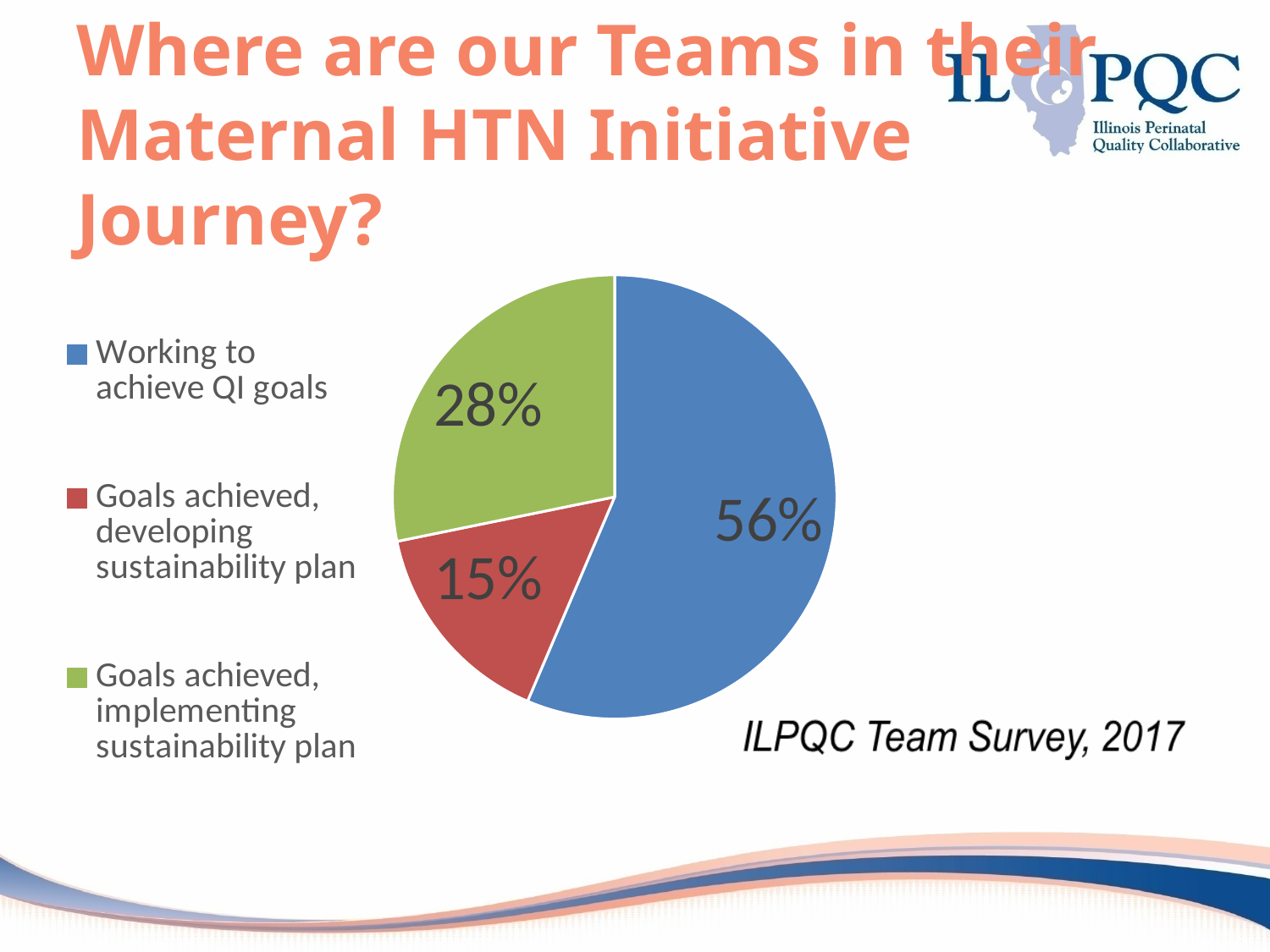
Which category has the smallest slice of the pie? Goals achieved, developing sustainability plan What is the difference in percentage points between 'Working to achieve QI goals' and 'Goals achieved, implementing sustainability plan'? 28 What kind of chart is shown on the slide? Pie chart Which is larger: the share for 'Goals achieved, implementing sustainability plan' or 'Goals achieved, developing sustainability plan'? Goals achieved, implementing sustainability plan How many categories does the pie chart show? 3 Which category has the largest slice of the pie? Working to achieve QI goals What share of teams are 'Goals achieved, implementing sustainability plan'? 28% What colour is the slice for 'Working to achieve QI goals'? Blue What share of teams are 'Goals achieved, developing sustainability plan'? 15% What share of teams are 'Working to achieve QI goals'? 56% What is the source noted below the pie chart? ILPQC Team Survey, 2017 What is the difference in percentage points between 'Goals achieved, implementing sustainability plan' and 'Goals achieved, developing sustainability plan'? 13